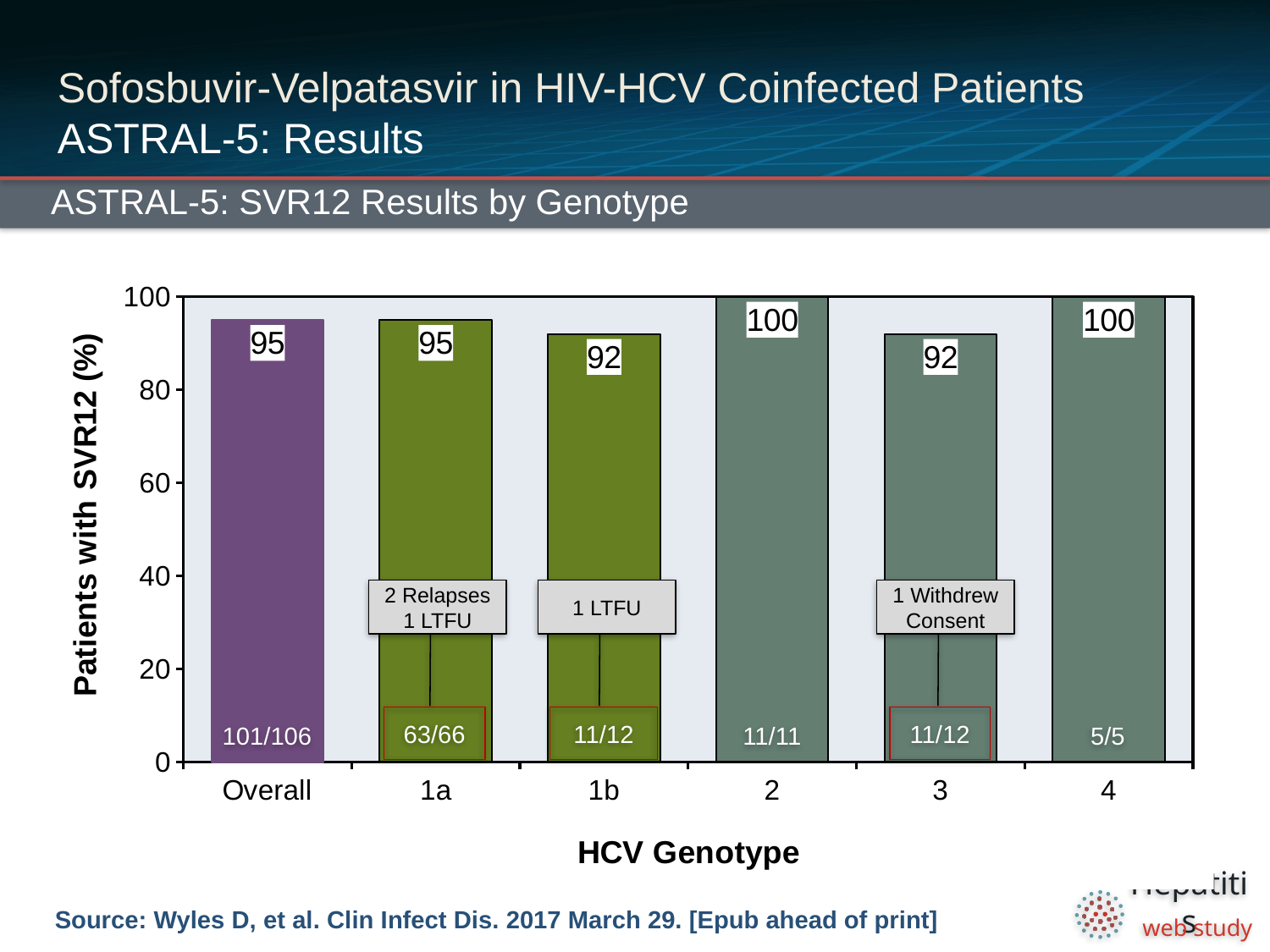
What is the label of the y axis? Patients with SVR12 (%) What annotation is shown on the genotype 3 bar? 1 Withdrew Consent What is the difference in SVR12 rate between genotype 2 and genotype 3? 8 What fraction of patients achieved SVR12 in genotype 1a? 63/66 Which genotypes have the highest SVR12 rate? 2 and 4 What is the SVR12 rate for the Overall group? 95 What kind of chart is shown on the slide? Bar chart How many genotype categories are shown on the x axis? 6 What is the SVR12 rate for genotype 2? 100 What is the SVR12 rate for genotype 1b? 92 What fraction of patients achieved SVR12 in the Overall group? 101/106 Which has a higher SVR12 rate, genotype 1a or genotype 1b? 1a